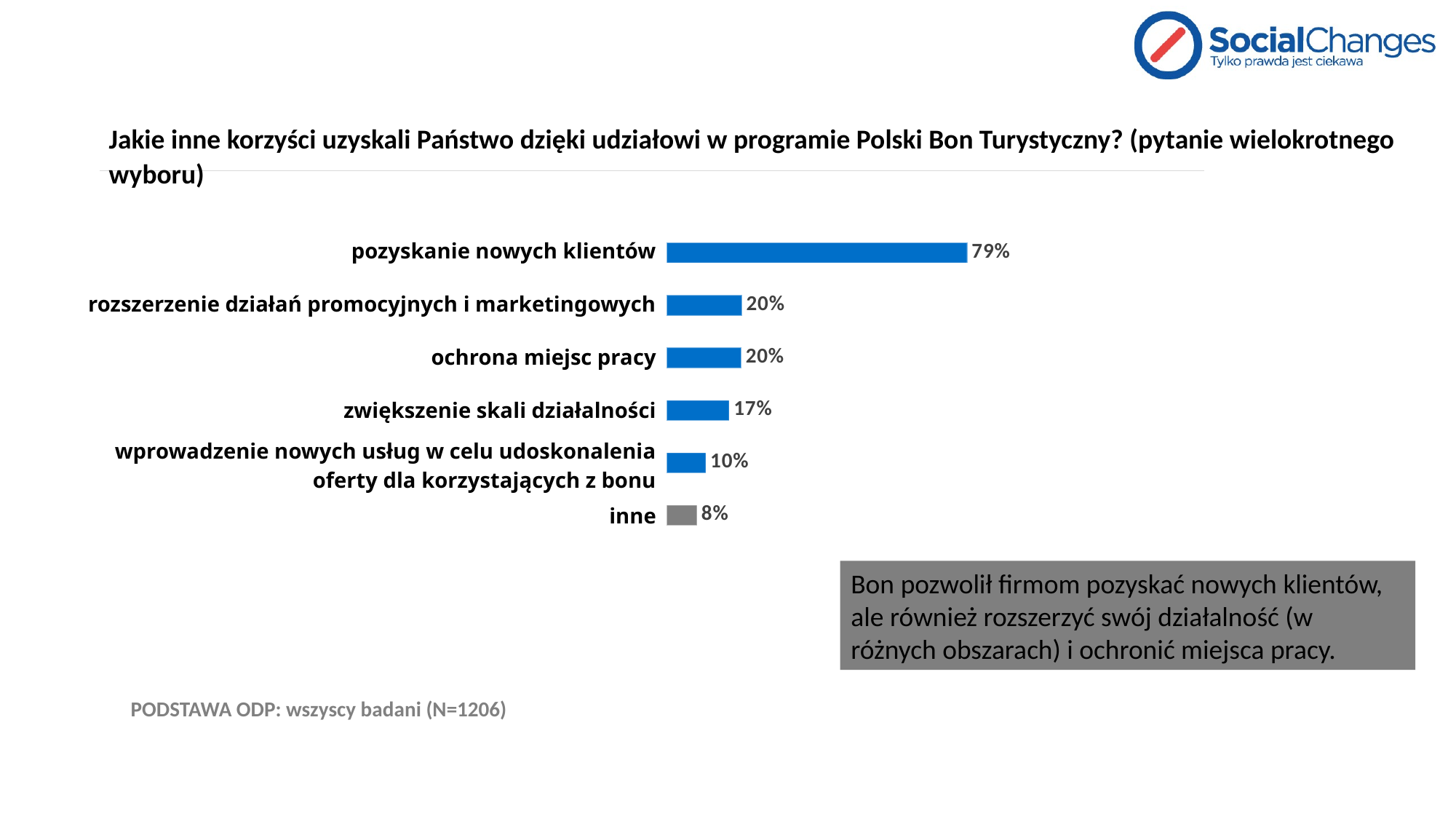
Which category has the highest value? pozyskanie nowych klientów Which category has the lowest value? inne What is the value for "pozyskanie nowych klientów"? 79% Which bar is coloured grey rather than blue? inne What is the value for "inne"? 8% What is the difference between the values for "rozszerzenie działań promocyjnych i marketingowych" and "wprowadzenie nowych usług w celu udoskonalenia oferty dla korzystających z bonu"? 10 percentage points What kind of chart is shown on the slide? Bar chart What is the value for "zwiększenie skali działalności"? 17% Which is larger: the value for "zwiększenie skali działalności" or the value for "inne"? zwiększenie skali działalności What is the difference between the values for "pozyskanie nowych klientów" and "ochrona miejsc pracy"? 59 percentage points What is the value for "wprowadzenie nowych usług w celu udoskonalenia oferty dla korzystających z bonu"? 10% How many categories are shown in the chart? 6